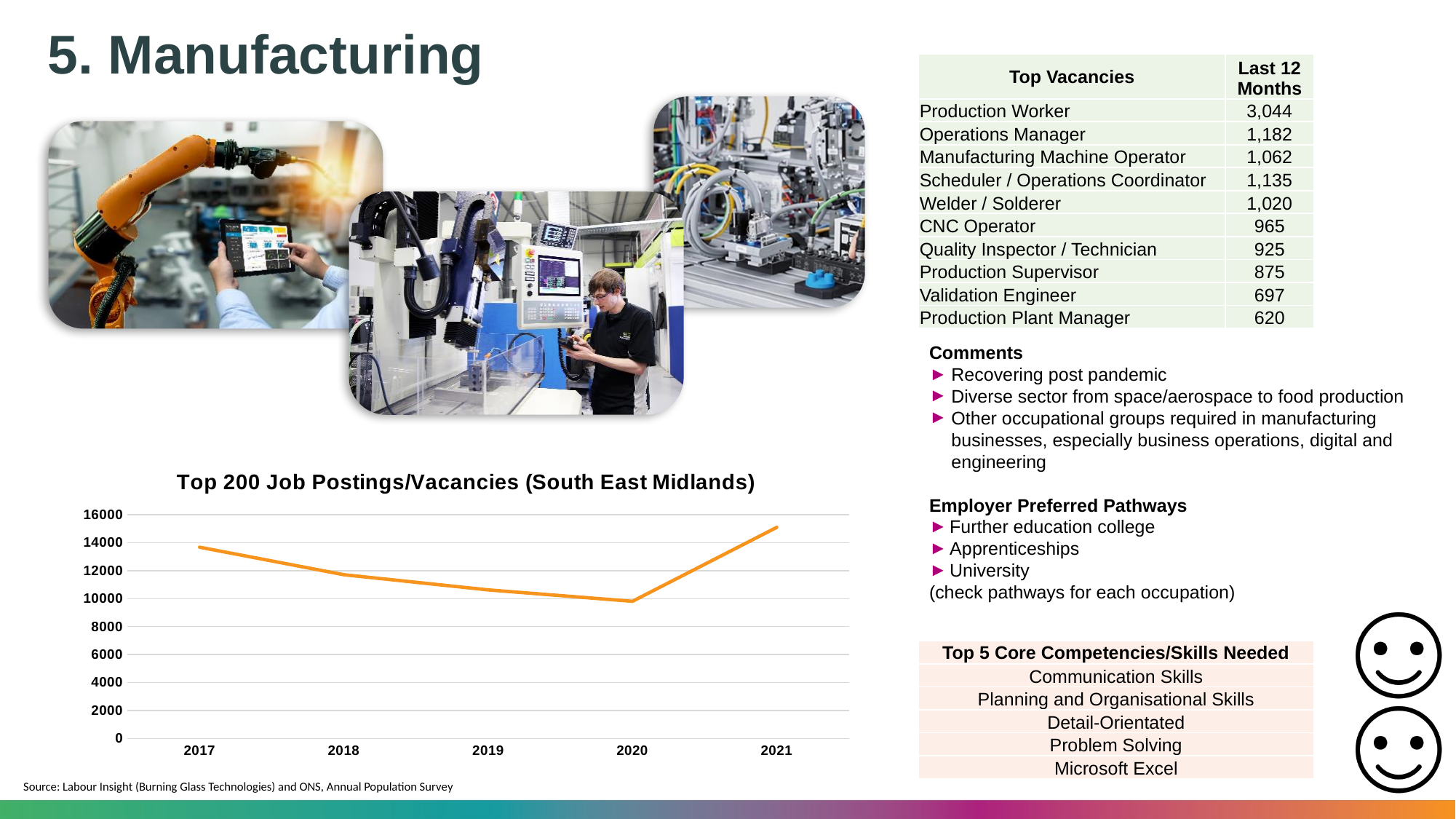
How many years are plotted on the x axis of the 'Top 200 Job Postings/Vacancies (South East Midlands)' chart? 5 In the 'Top 200 Job Postings/Vacancies (South East Midlands)' chart, which year has the lowest value? 2020 In the 'Top 200 Job Postings/Vacancies (South East Midlands)' chart, which year has the highest value? 2021 In the 'Top 200 Job Postings/Vacancies (South East Midlands)' chart, is the value for 2021 greater or less than 14000? greater In the 'Top 200 Job Postings/Vacancies (South East Midlands)' chart, do the values rise or fall from 2020 to 2021? rise In the 'Top 200 Job Postings/Vacancies (South East Midlands)' chart, is the value for 2017 greater or less than 12000? greater In the 'Top 200 Job Postings/Vacancies (South East Midlands)' chart, do the values rise or fall from 2017 to 2020? fall What is the title of the line chart on the slide? Top 200 Job Postings/Vacancies (South East Midlands) In the 'Top 200 Job Postings/Vacancies (South East Midlands)' chart, is the value for 2019 greater or less than 12000? less What kind of chart is 'Top 200 Job Postings/Vacancies (South East Midlands)'? line chart In the 'Top 200 Job Postings/Vacancies (South East Midlands)' chart, which year has the larger value, 2017 or 2018? 2017 In the 'Top 200 Job Postings/Vacancies (South East Midlands)' chart, which year has the larger value, 2017 or 2021? 2021